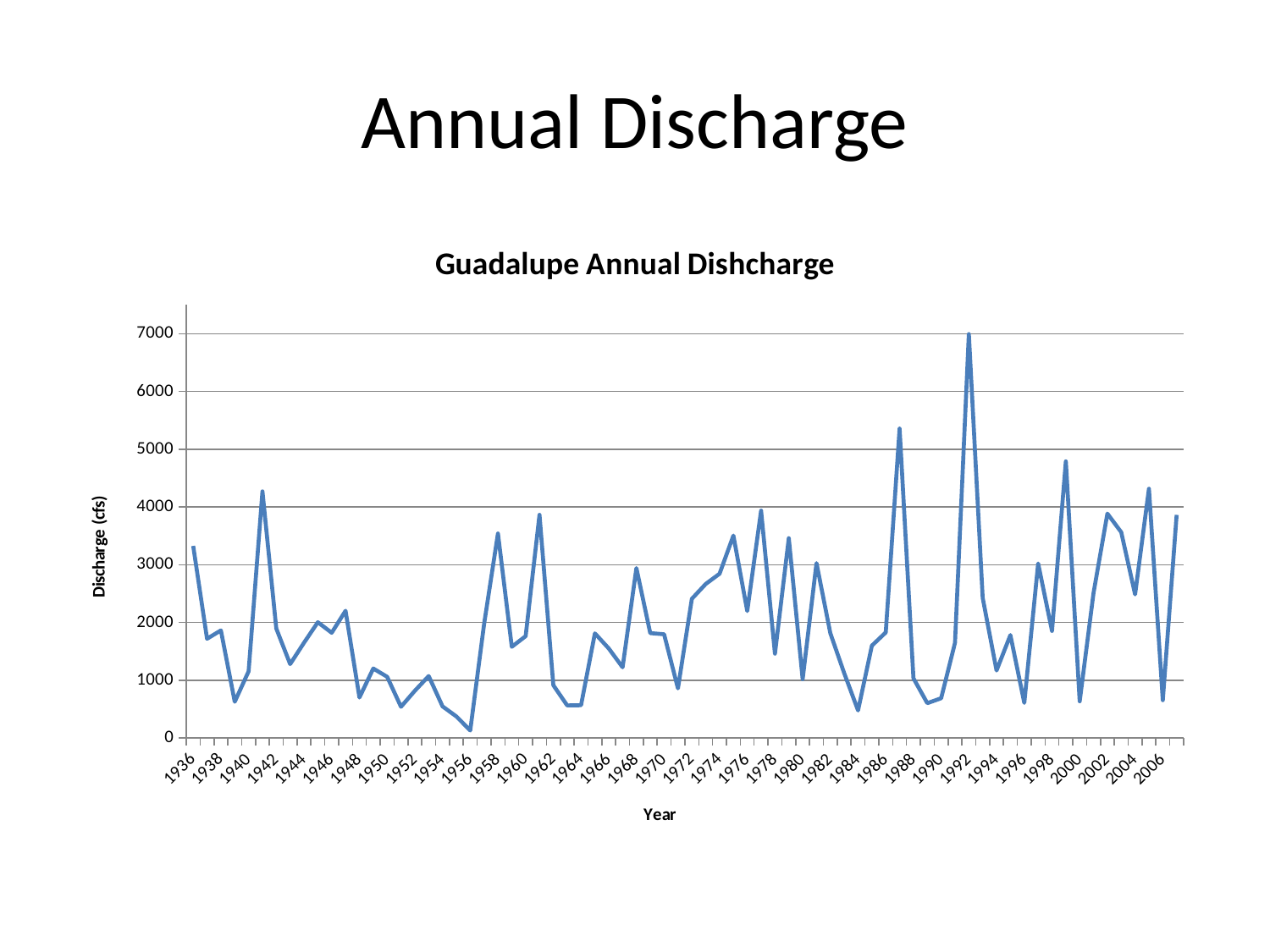
Is the value for 1999 greater or less than 4000? greater What kind of chart is shown on the slide? line chart What is the title of the chart? Guadalupe Annual Dishcharge Is the value for 1936 greater or less than 3000? greater In which year is the discharge highest? 1992 Which year has the larger discharge, 1987 or 1999? 1987 Which year has the larger discharge, 1992 or 1987? 1992 What is the label of the vertical axis? Discharge (cfs) In which year is the discharge lowest? 1956 Is the value for 1984 greater or less than 1000? less